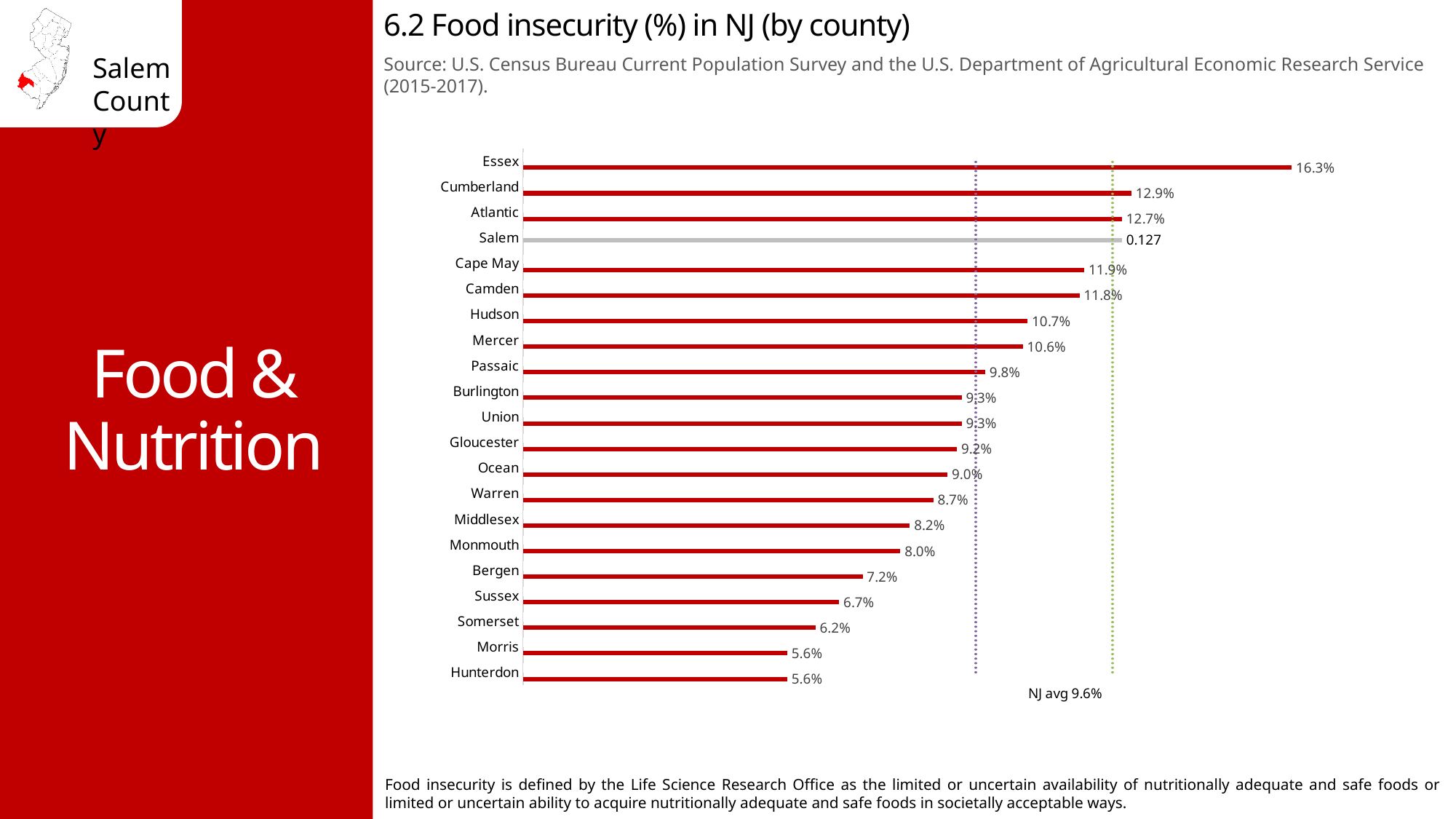
What is the food insecurity value shown for Essex? 16.3% What is the lowest food insecurity value shown on the chart? 5.6% What value is labelled on the bar for Salem? 0.127 What kind of chart is shown on the slide? Bar chart Which county has the highest food insecurity value on the chart? Essex What is the food insecurity value shown for Bergen? 7.2% What NJ average value is noted on the chart? 9.6% What value is labelled on the bar for Cumberland? 12.9% How many counties are shown on the chart? 21 What is the difference between the values for Essex and Cumberland? 3.4 percentage points What is the food insecurity value shown for Hudson? 10.7% Which has a higher food insecurity value, Hudson or Bergen? Hudson